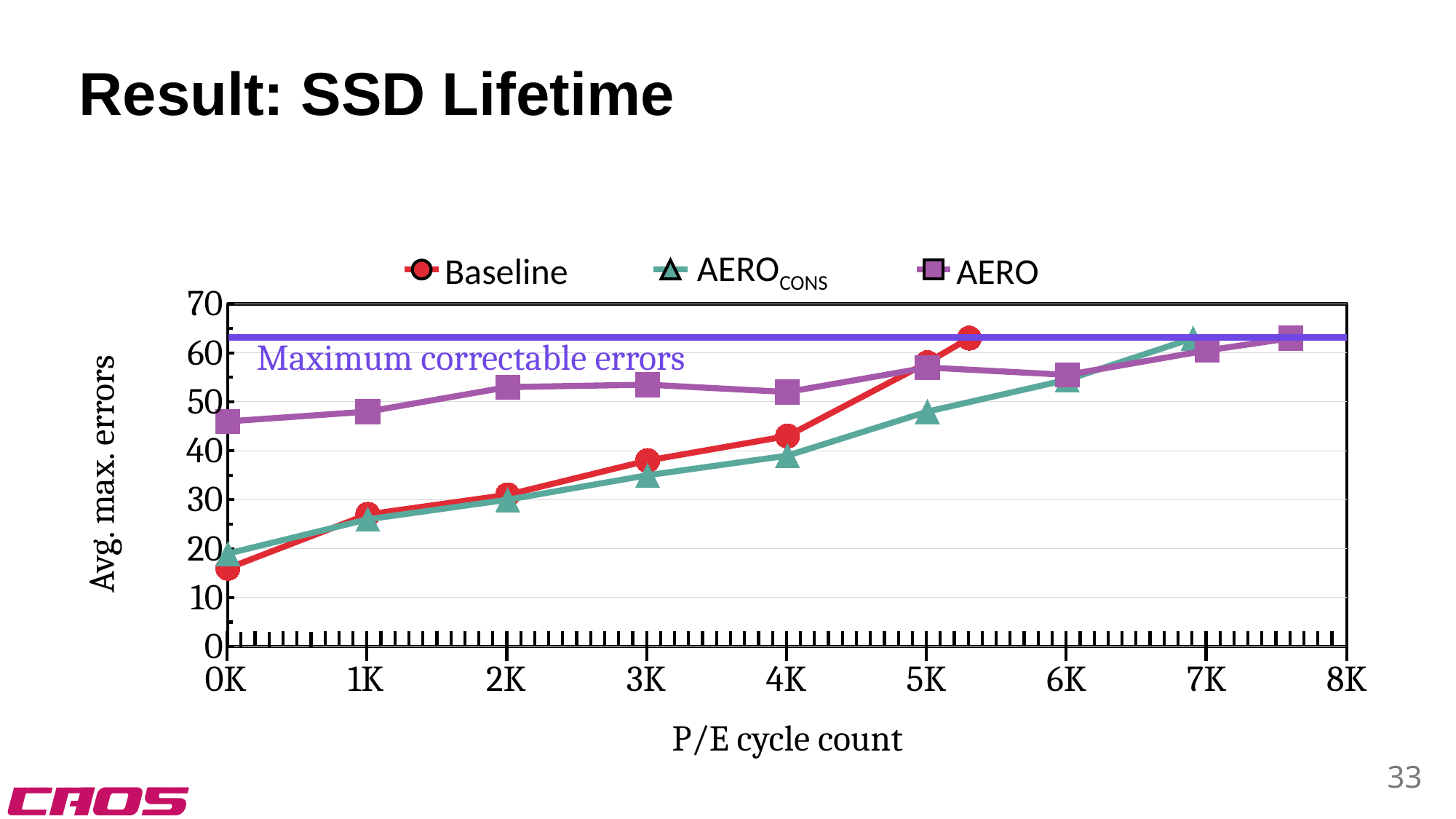
Does the Baseline series rise or fall as the P/E cycle count increases? rise What does the horizontal purple line across the chart represent? Maximum correctable errors At 3K P/E cycles, which series has the higher avg. max. errors, Baseline or AERO_CONS? Baseline Is the Baseline value at 4K P/E cycles greater or less than 40? greater How many series does the legend list? 3 Is the AERO value at 0K P/E cycles greater or less than 40? greater What kind of chart is shown on the slide? line chart Is the Baseline value at 1K P/E cycles greater or less than 20? greater What are the three series named in the legend? Baseline, AERO_CONS, AERO Which series reaches the maximum correctable errors line at the lowest P/E cycle count? Baseline At 0K P/E cycles, which series has the higher avg. max. errors, AERO or Baseline? AERO